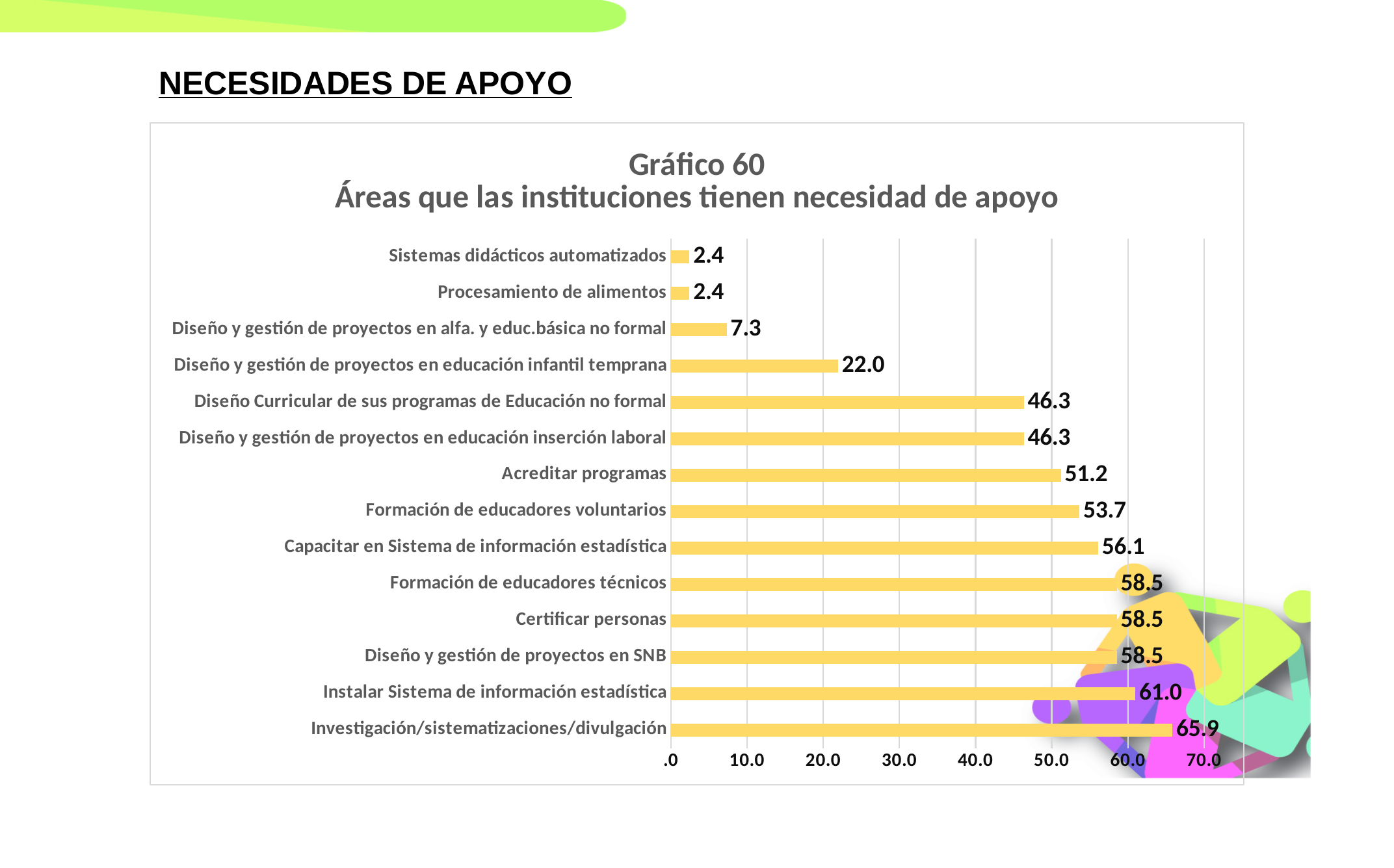
Is the value for Formación de educadores técnicos greater or less than 50.0? greater Which is larger, the value for Acreditar programas or the value for Diseño Curricular de sus programas de Educación no formal? Acreditar programas What is the value for Formación de educadores voluntarios? 53.7 What is the title of the chart? Gráfico 60 Áreas que las instituciones tienen necesidad de apoyo How many categories are shown in the chart? 14 What is the difference between the values for Investigación/sistematizaciones/divulgación and Diseño y gestión de proyectos en alfa. y educ.básica no formal? 58.6 What is the value for Investigación/sistematizaciones/divulgación? 65.9 What is the value for Diseño y gestión de proyectos en educación infantil temprana? 22.0 What kind of chart is shown on the slide? bar chart What is the difference between the values for Instalar Sistema de información estadística and Capacitar en Sistema de información estadística? 4.9 Which category has the highest value? Investigación/sistematizaciones/divulgación What is the value for Acreditar programas? 51.2